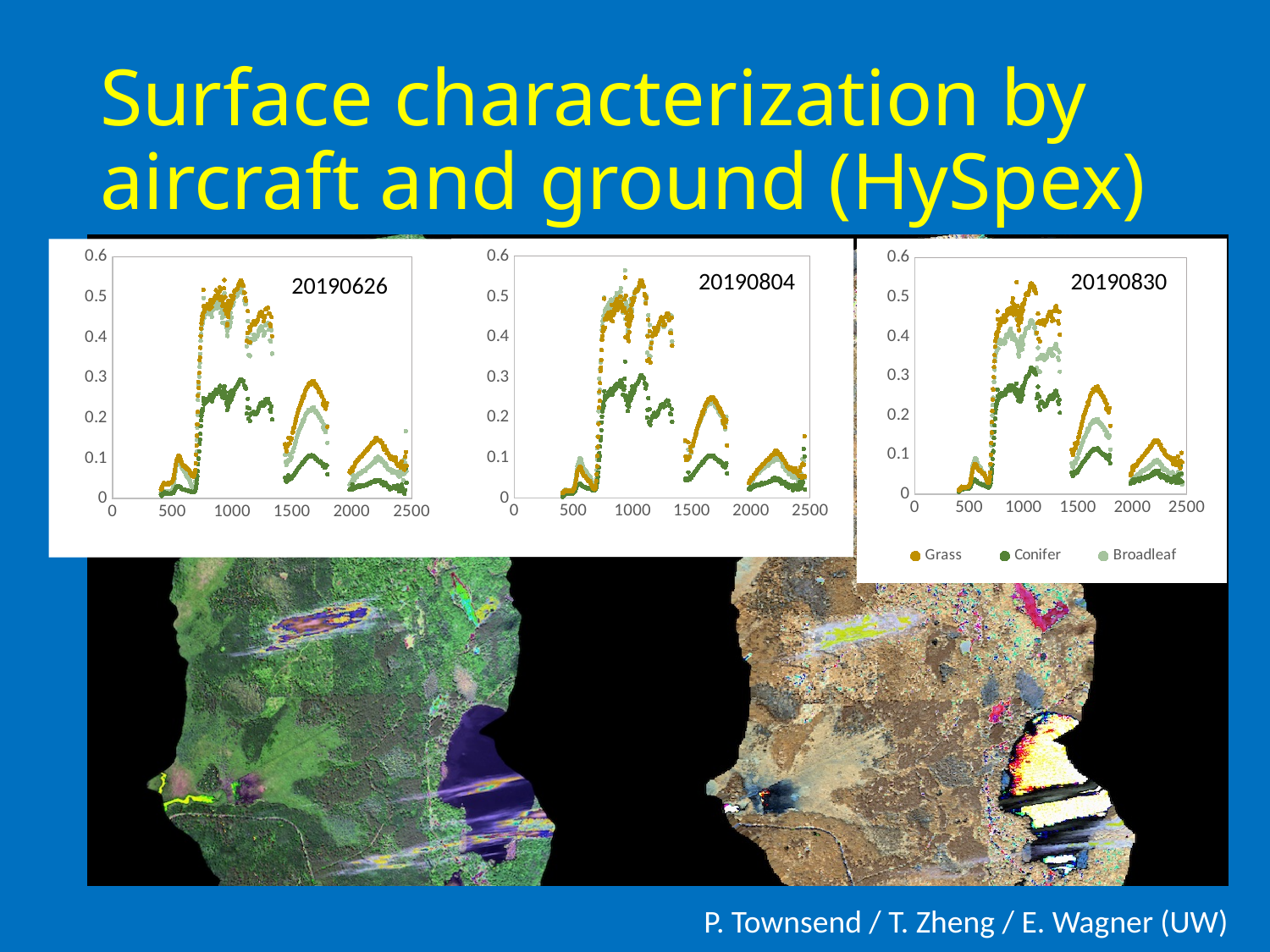
What is the highest tick value shown on the x axis of the chart labelled 20190830? 2500 In the chart labelled 20190626, which series has the lowest values around x = 1000? Conifer What kind of chart is the one labelled 20190626? scatter chart What are the three series named in the legend? Grass, Conifer, Broadleaf In the chart labelled 20190626, around x = 1700, which series is larger, Broadleaf or Conifer? Broadleaf How many charts are shown on the slide? 3 In the chart labelled 20190804, is the peak value for Conifer greater or less than 0.4? less How many series does the legend list for the charts? 3 In the chart labelled 20190804, around x = 1700, which series is larger, Grass or Conifer? Grass In the chart labelled 20190626, is the peak value for Grass greater or less than 0.5? greater In the chart labelled 20190830, is the value for Conifer around x = 2200 greater or less than 0.1? less In the chart labelled 20190830, which series has the highest values around x = 1000? Grass